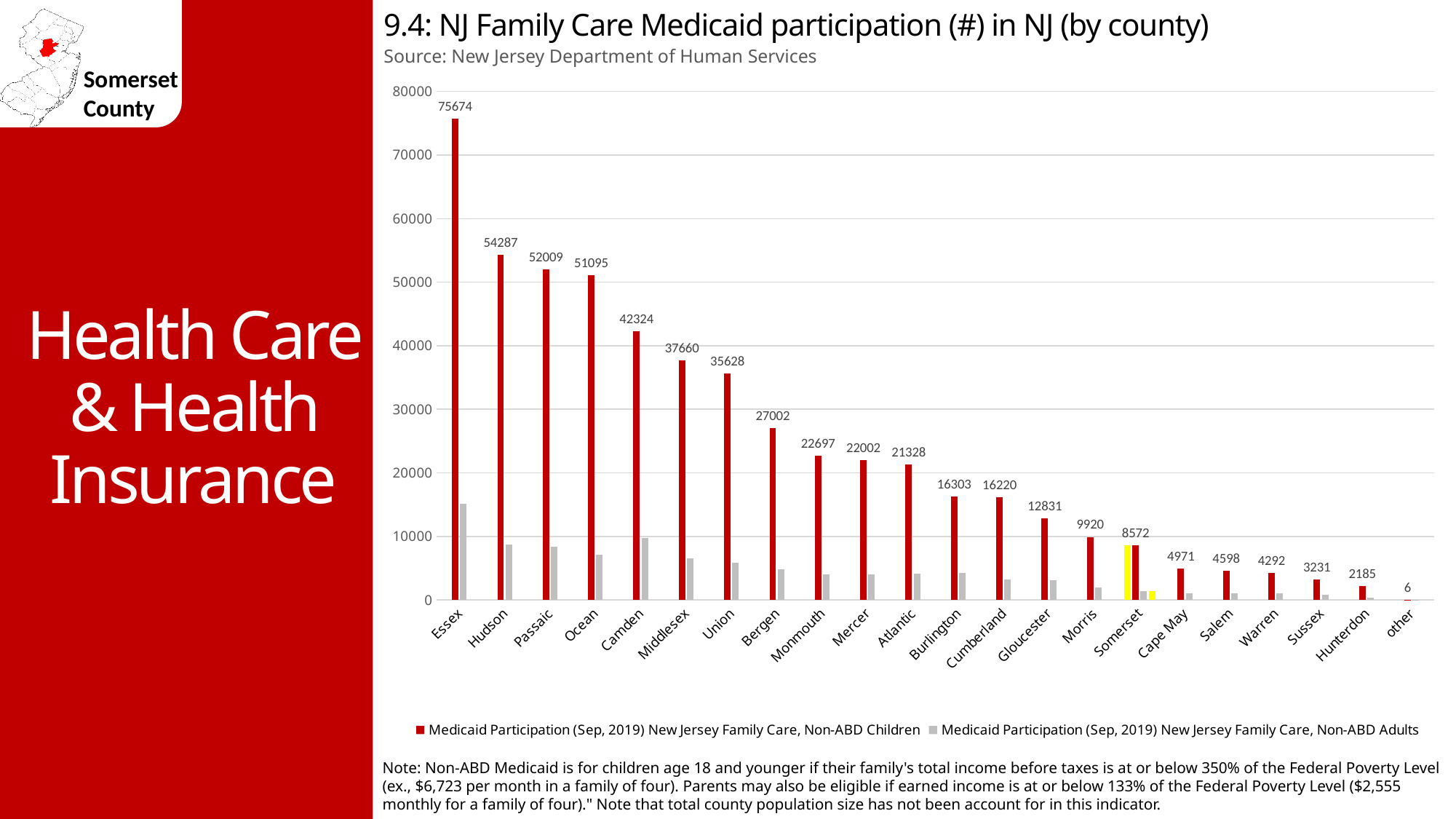
What is the difference between the Non-ABD Children values for Hudson and Passaic? 2278 How many series does the legend list? 2 Which county (excluding 'other') has the lowest Non-ABD Children Medicaid participation? Hunterdon What is the Non-ABD Children Medicaid participation value for Somerset? 8572 Which has a larger Non-ABD Children value, Bergen or Monmouth? Bergen Which county has the highest Non-ABD Children Medicaid participation? Essex What kind of chart is shown on the slide? Bar chart What is the Non-ABD Children Medicaid participation value for Essex? 75674 Is the Non-ABD Adults value for Essex greater or less than 10000? greater How many categories are shown on the x axis? 22 What is the Non-ABD Children Medicaid participation value for Camden? 42324 Do the Non-ABD Children values rise or fall moving from left to right along the x axis? Fall